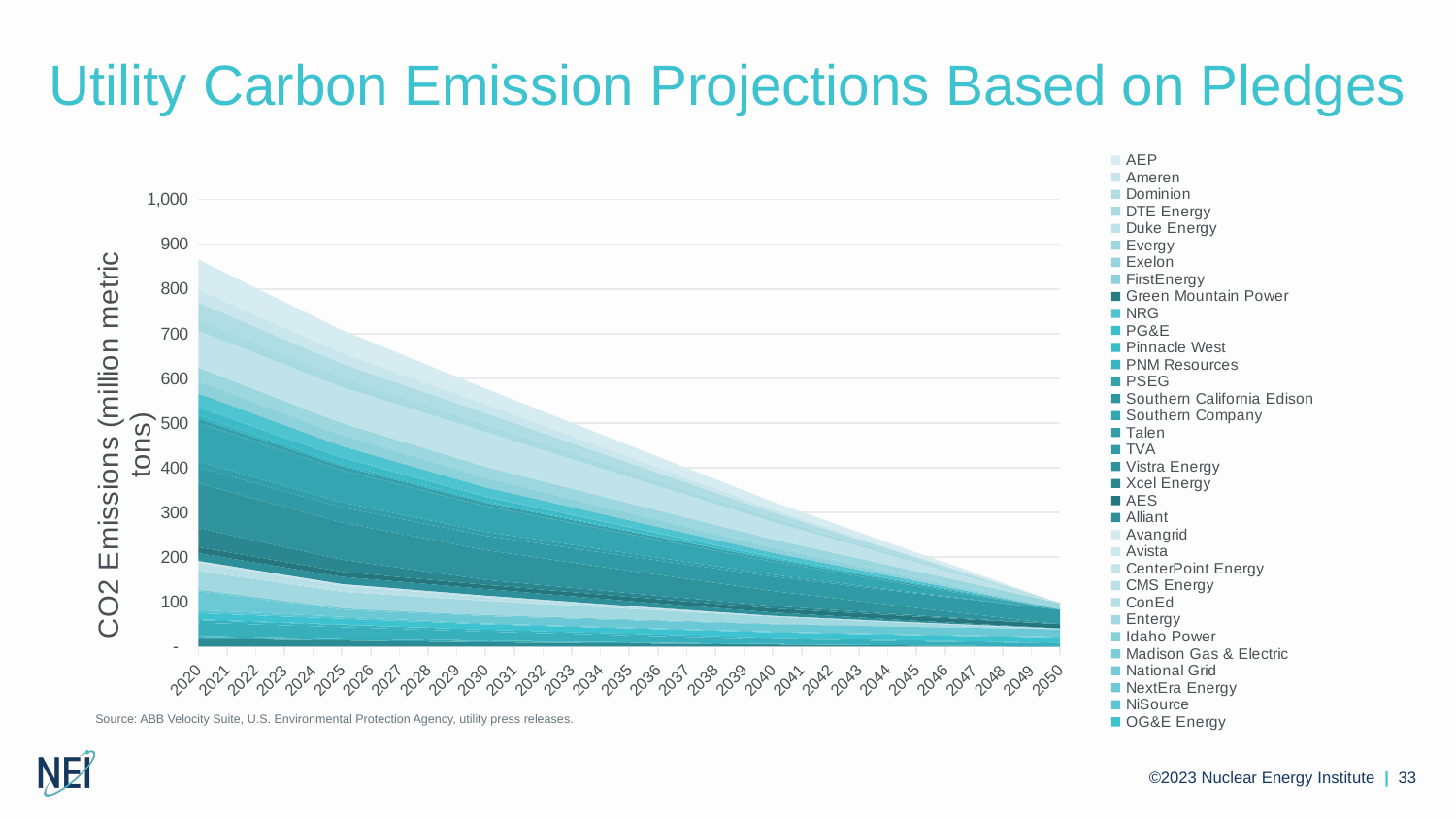
How many utilities does the legend list? 34 Which year has the highest total projected CO2 emissions? 2020 What is the title of the chart on the slide? Utility Carbon Emission Projections Based on Pledges Is the total projected CO2 emissions value for 2035 greater or less than 600 million metric tons? less What kind of chart is shown on the slide? Stacked area chart Is the total projected CO2 emissions value for 2020 greater or less than 800 million metric tons? greater What is the label on the y axis of the chart? CO2 Emissions (million metric tons) Which year has higher total projected CO2 emissions, 2025 or 2045? 2025 How many years are shown along the x axis? 31 Do total projected CO2 emissions rise or fall from 2020 to 2050? Fall Which year has the lowest total projected CO2 emissions? 2050